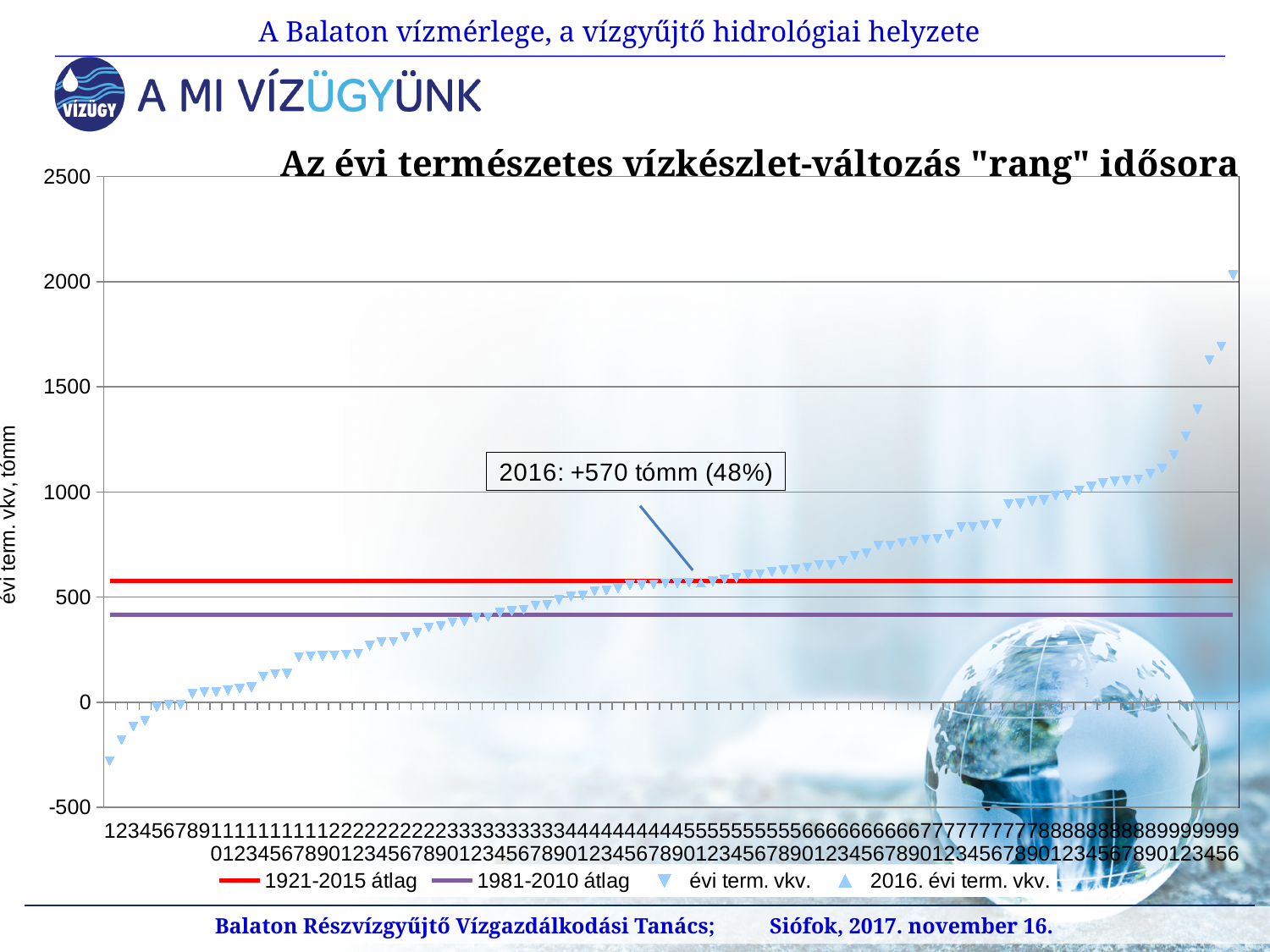
What is the title of the chart? Az évi természetes vízkészlet-változás "rang" idősora According to the annotation, what is the 2016 annual natural water balance change value? +570 tómm Is the 1921-2015 átlag line greater or less than 500? greater Which average line is higher, 1921-2015 átlag or 1981-2010 átlag? 1921-2015 átlag How many series does the chart legend list? 4 What kind of chart is shown on the slide? line chart Do the plotted annual values rise or fall along the x axis? rise Is the highest plotted annual value greater or less than 1500? greater Is the lowest plotted annual value greater or less than 0? less What percentage is given in the annotation for 2016? 48% What is the label of the vertical axis? évi term. vkv, tómm